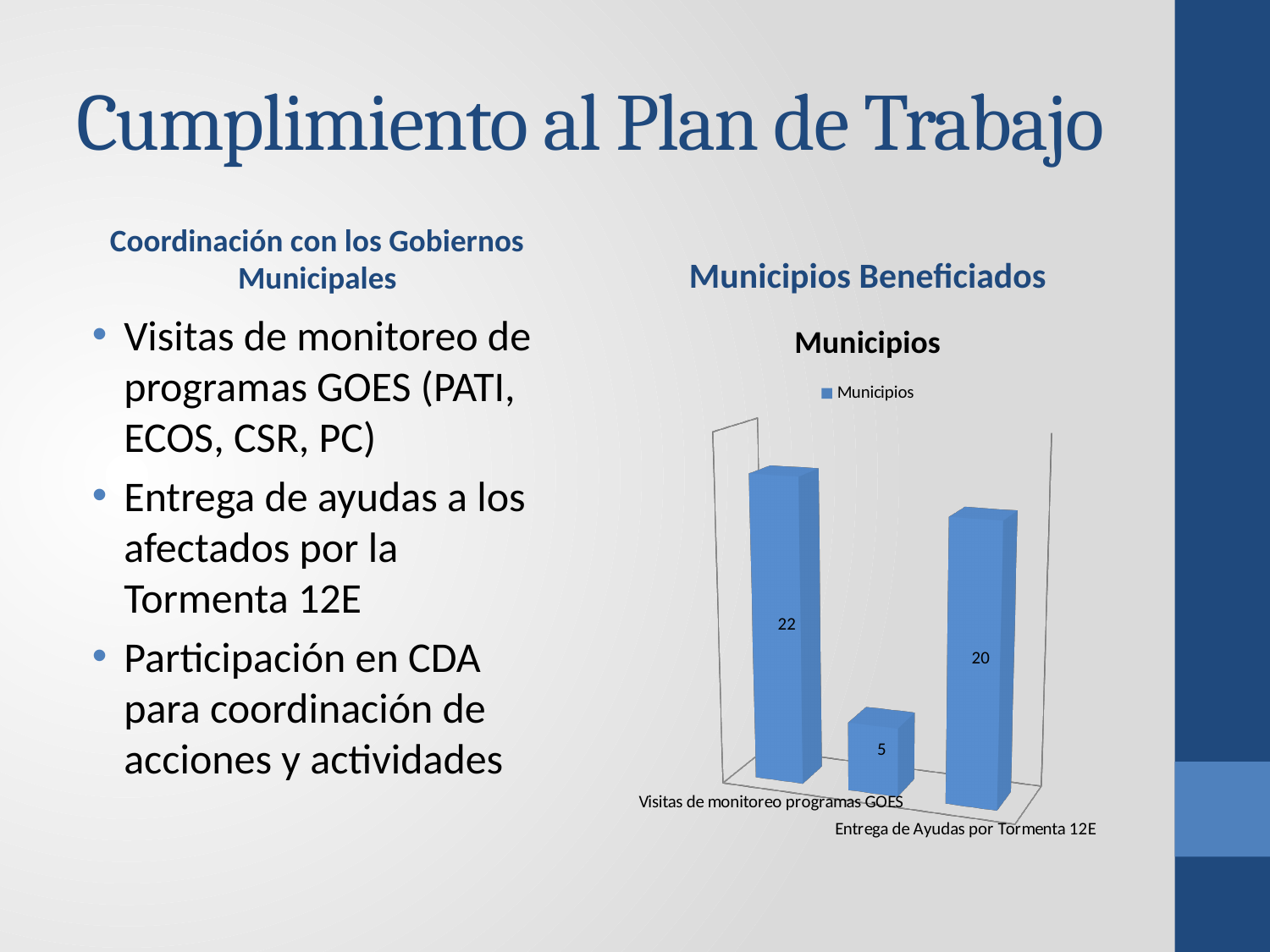
What is the title of the chart on the slide? Municipios What is the difference between the values for Visitas de monitoreo programas GOES and Entrega de Ayudas por Tormenta 12E? 2 What kind of chart is shown on the slide? Bar chart How many bars are plotted in the Municipios chart? 3 Which category has the highest value in the Municipios chart? Visitas de monitoreo programas GOES What is the value for Visitas de monitoreo programas GOES in the Municipios chart? 22 How much larger is the value for Visitas de monitoreo programas GOES than the value of the middle bar? 17 What is the lowest value shown in the Municipios chart? 5 How many series does the legend of the Municipios chart list? 1 What is the value shown on the middle bar of the Municipios chart? 5 What is the value for Entrega de Ayudas por Tormenta 12E in the Municipios chart? 20 Which is larger: the value for Visitas de monitoreo programas GOES or for Entrega de Ayudas por Tormenta 12E? Visitas de monitoreo programas GOES